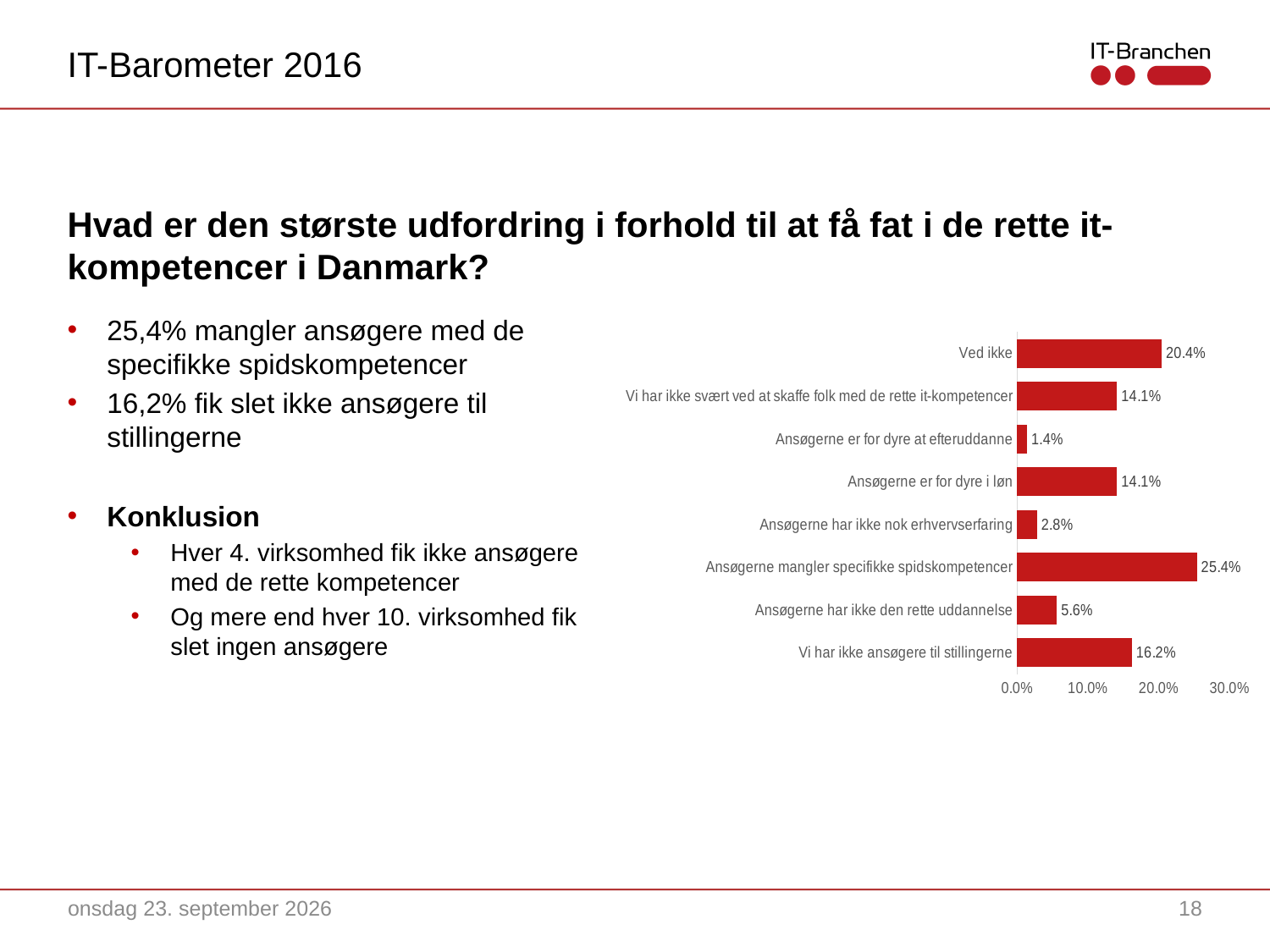
What is the value for "Ansøgerne har ikke den rette uddannelse"? 5.6% How many categories are shown in the chart? 8 What kind of chart is shown on the slide? bar chart Which category has the highest value? Ansøgerne mangler specifikke spidskompetencer Which category has the lowest value? Ansøgerne er for dyre at efteruddanne What is the value for "Vi har ikke ansøgere til stillingerne"? 16.2% What is the value for "Ansøgerne mangler specifikke spidskompetencer"? 25.4% Is the value for "Ansøgerne har ikke nok erhvervserfaring" greater or less than 10.0%? less What is the value for "Ved ikke"? 20.4% What is the highest value shown on the x axis? 30.0% What is the difference between "Ansøgerne mangler specifikke spidskompetencer" and "Vi har ikke ansøgere til stillingerne"? 9.2% Which is larger: "Ved ikke" or "Vi har ikke svært ved at skaffe folk med de rette it-kompetencer"? Ved ikke